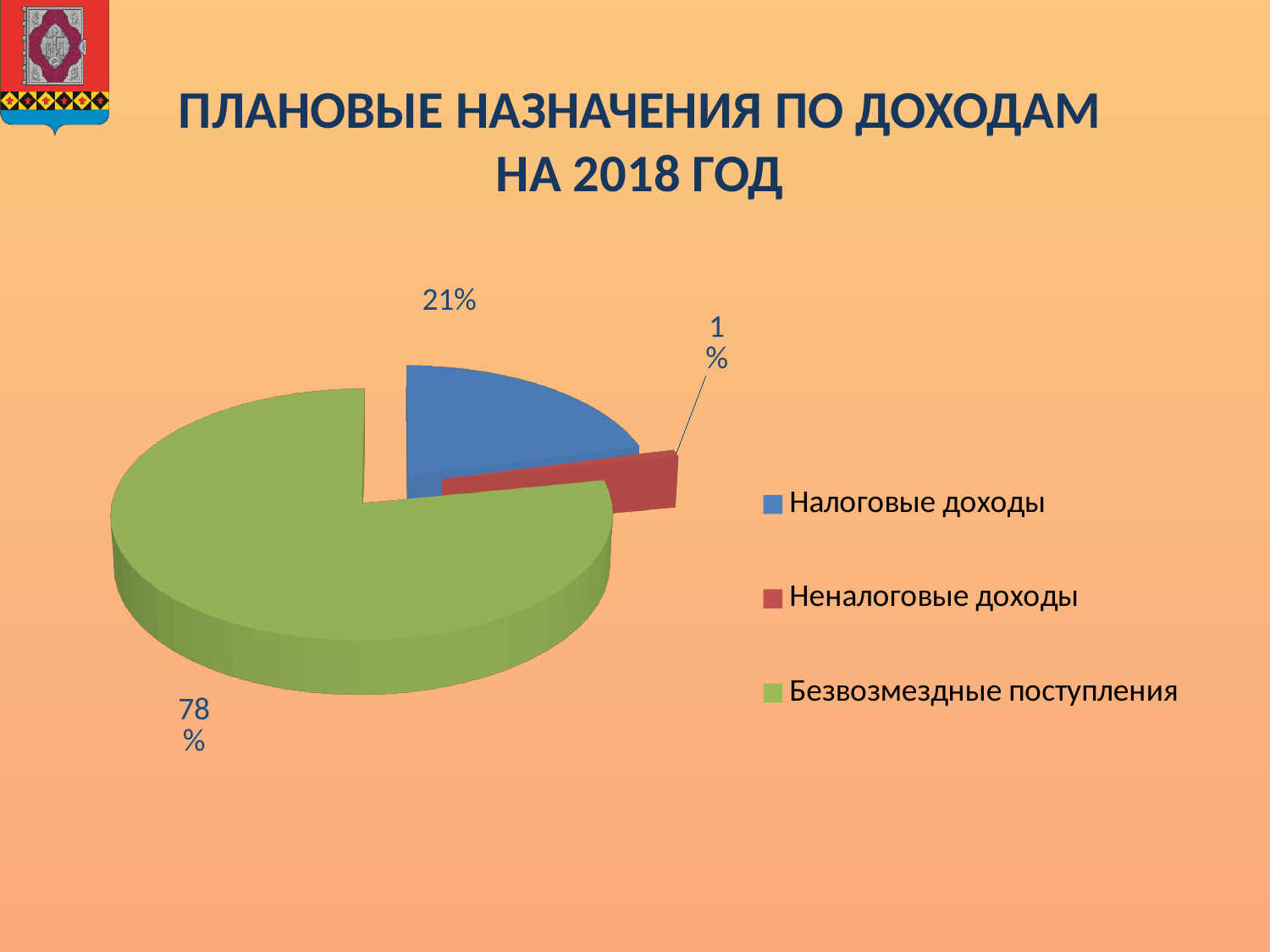
Which is larger, Налоговые доходы or Неналоговые доходы? Налоговые доходы What is the difference in percentage points between Безвозмездные поступления and Налоговые доходы? 57 What kind of chart is shown on the slide? pie chart What share of the pie does Неналоговые доходы have? 1% Which category has the smallest slice of the pie? Неналоговые доходы What colour is the slice for Безвозмездные поступления? green How many categories does the pie chart show? 3 What share of the pie does Налоговые доходы have? 21% What is the title of the slide containing the chart? ПЛАНОВЫЕ НАЗНАЧЕНИЯ ПО ДОХОДАМ НА 2018 ГОД What share of the pie does Безвозмездные поступления have? 78% What is the difference in percentage points between Налоговые доходы and Неналоговые доходы? 20 Which category has the largest slice of the pie? Безвозмездные поступления